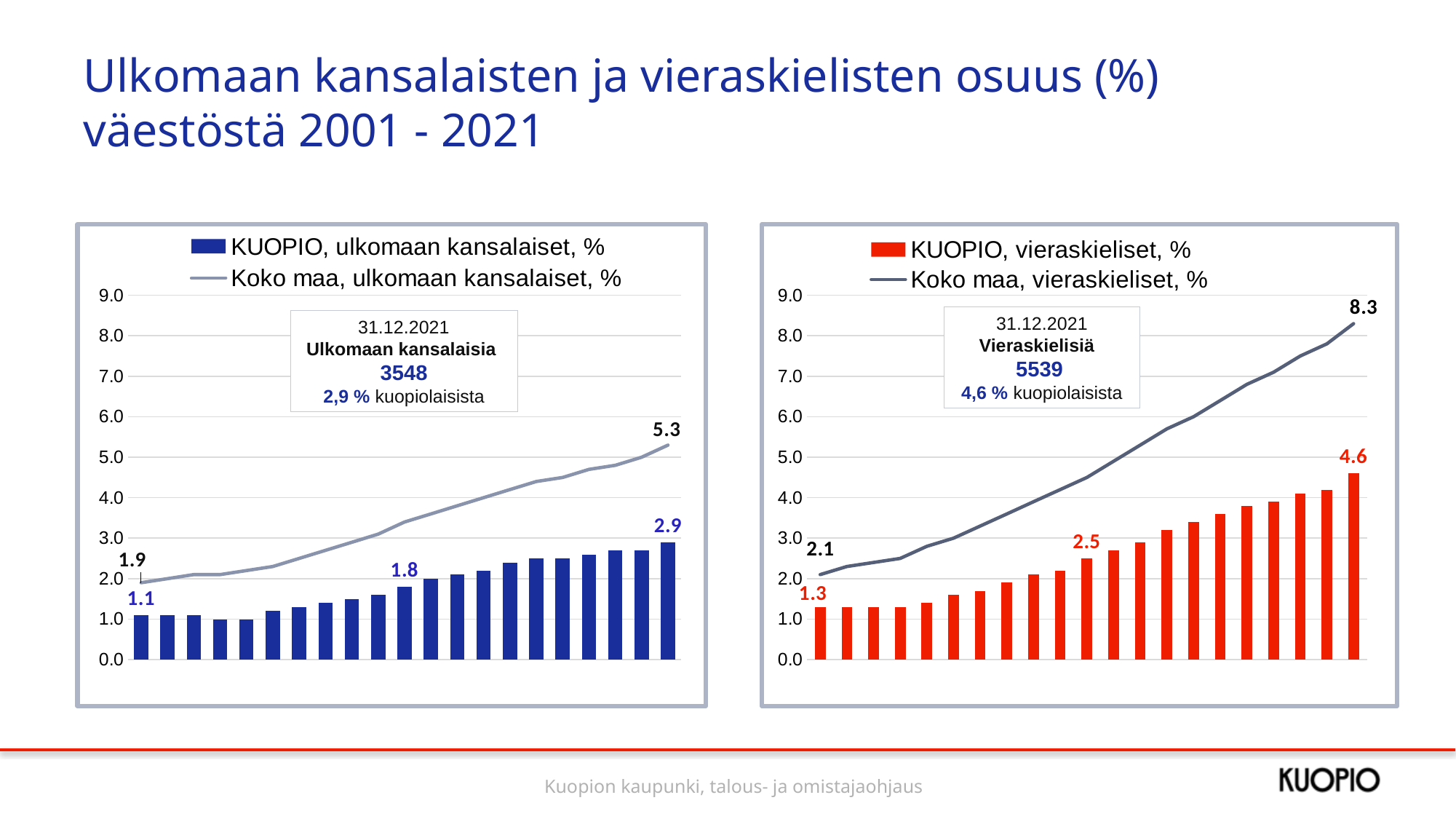
In the right chart, by how much did the Koko maa, vieraskieliset, % line rise from its first labelled value (2.1) to its last labelled value (8.3)? 6.2 In the right chart, what is the highest labelled value of the KUOPIO, vieraskieliset, % bars? 4.6 In the right chart, which is larger at the end of the period: the Koko maa, vieraskieliset, % line or the KUOPIO, vieraskieliset, % bar? Koko maa, vieraskieliset, % In the left chart, what is the final labelled value of the KUOPIO, ulkomaan kansalaiset, % bars? 2.9 In the left chart, do the KUOPIO, ulkomaan kansalaiset, % bars generally rise or fall from left to right? rise In the right chart, what is the first labelled value of the Koko maa, vieraskieliset, % line? 2.1 How many bars are plotted in the left chart? 21 In the right chart, is the first KUOPIO, vieraskieliset, % bar (1.3) greater or less than 2.0? less In the left chart, what is the last labelled value of the Koko maa, ulkomaan kansalaiset, % line? 5.3 How many series does the legend of the right chart list? 2 In the left chart, what is the difference between the last labelled value of the Koko maa line (5.3) and the last labelled Kuopio bar (2.9)? 2.4 What colour are the KUOPIO, vieraskieliset, % bars in the right chart? red